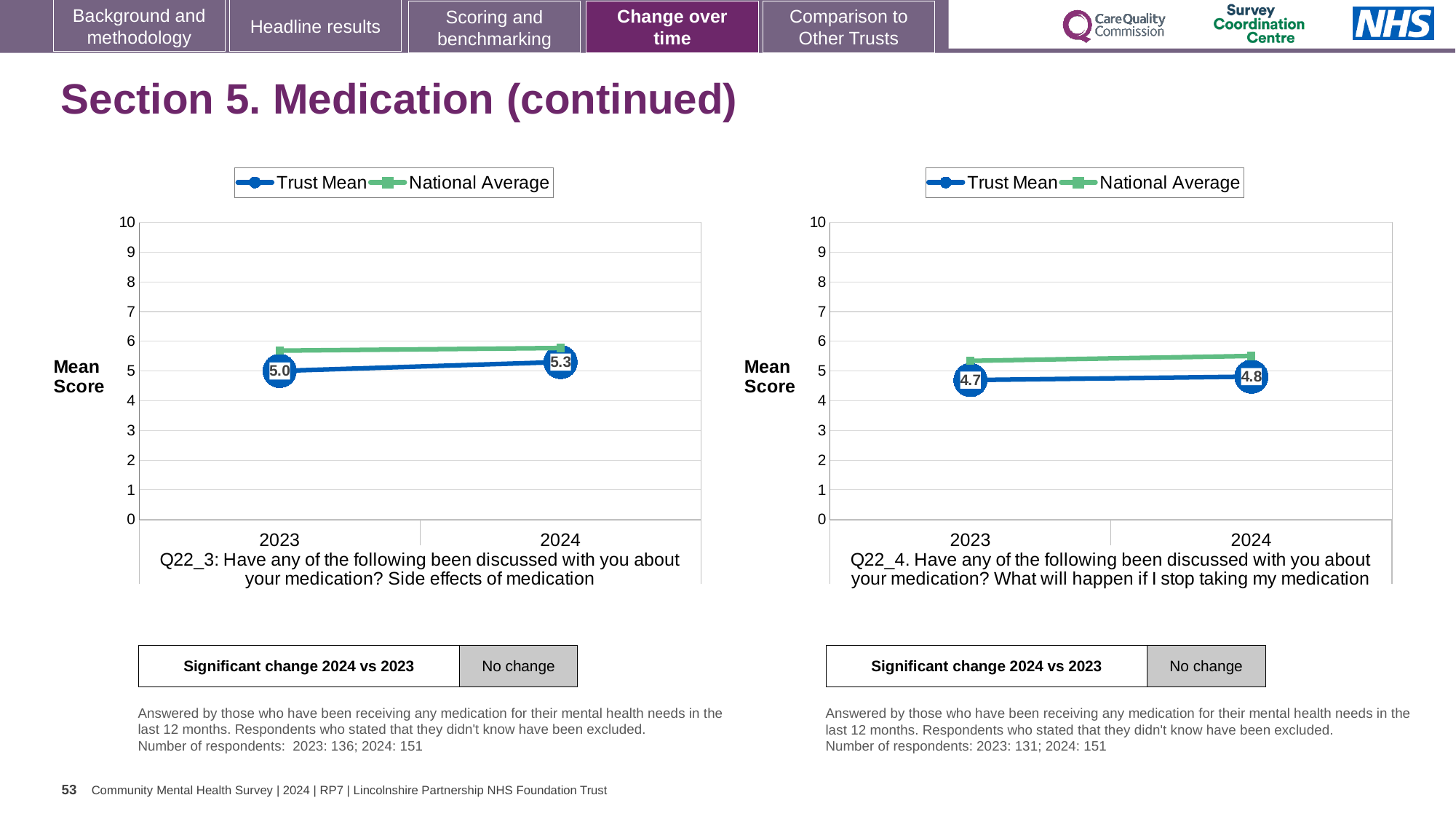
In the left chart (Q22_3), what is the Trust Mean score for 2024? 5.3 In the left chart (Q22_3), by how much did the Trust Mean change from 2023 to 2024? 0.3 In the left chart (Q22_3), which series is higher in 2024, Trust Mean or National Average? National Average In the right chart (Q22_4), is the National Average for 2023 greater or less than 5? greater How many years are shown on the x axis of the right chart (Q22_4)? 2 In the right chart (Q22_4), what is the Trust Mean score for 2024? 4.8 In the left chart (Q22_3), does the Trust Mean rise or fall from 2023 to 2024? rise In the left chart (Q22_3), what is the Trust Mean score for 2023? 5.0 What type of chart is the left chart (Q22_3)? line chart In the right chart (Q22_4), what is the difference between the Trust Mean for 2024 and 2023? 0.1 How many series does the legend of the right chart (Q22_4) list? 2 In the right chart (Q22_4), what is the Trust Mean score for 2023? 4.7